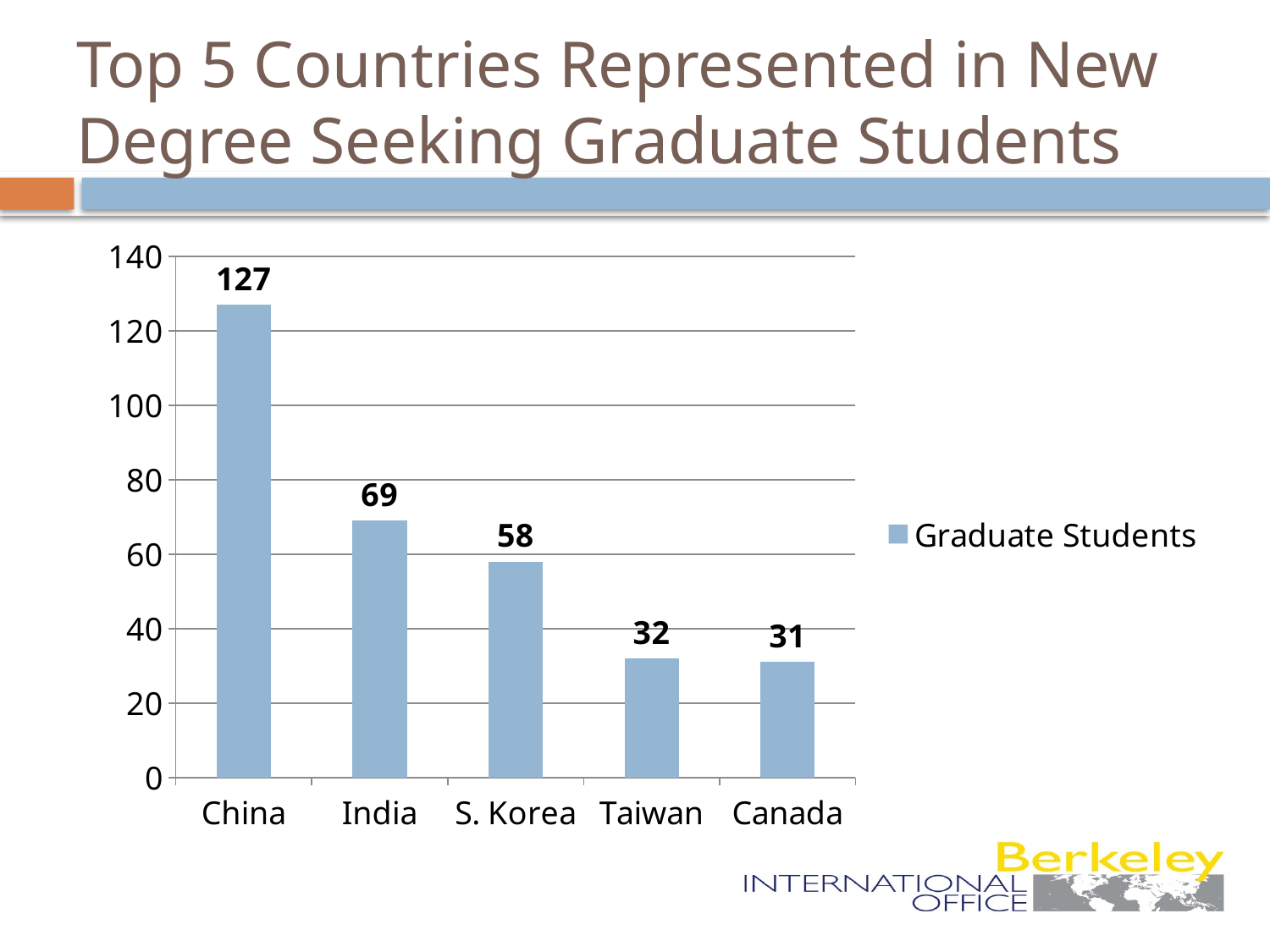
What series name is listed in the legend? Graduate Students Which country has the lowest number of graduate students? Canada Is the value for S. Korea greater or less than 40? greater What is the value for S. Korea? 58 How many countries are shown on the chart? 5 What is the value for Canada? 31 What kind of chart is shown on the slide? Bar chart What is the difference between the values for China and India? 58 What is the difference between the values for India and S. Korea? 11 Which is larger, the value for India or the value for Taiwan? India Which country has the highest number of graduate students? China What is the value for China? 127